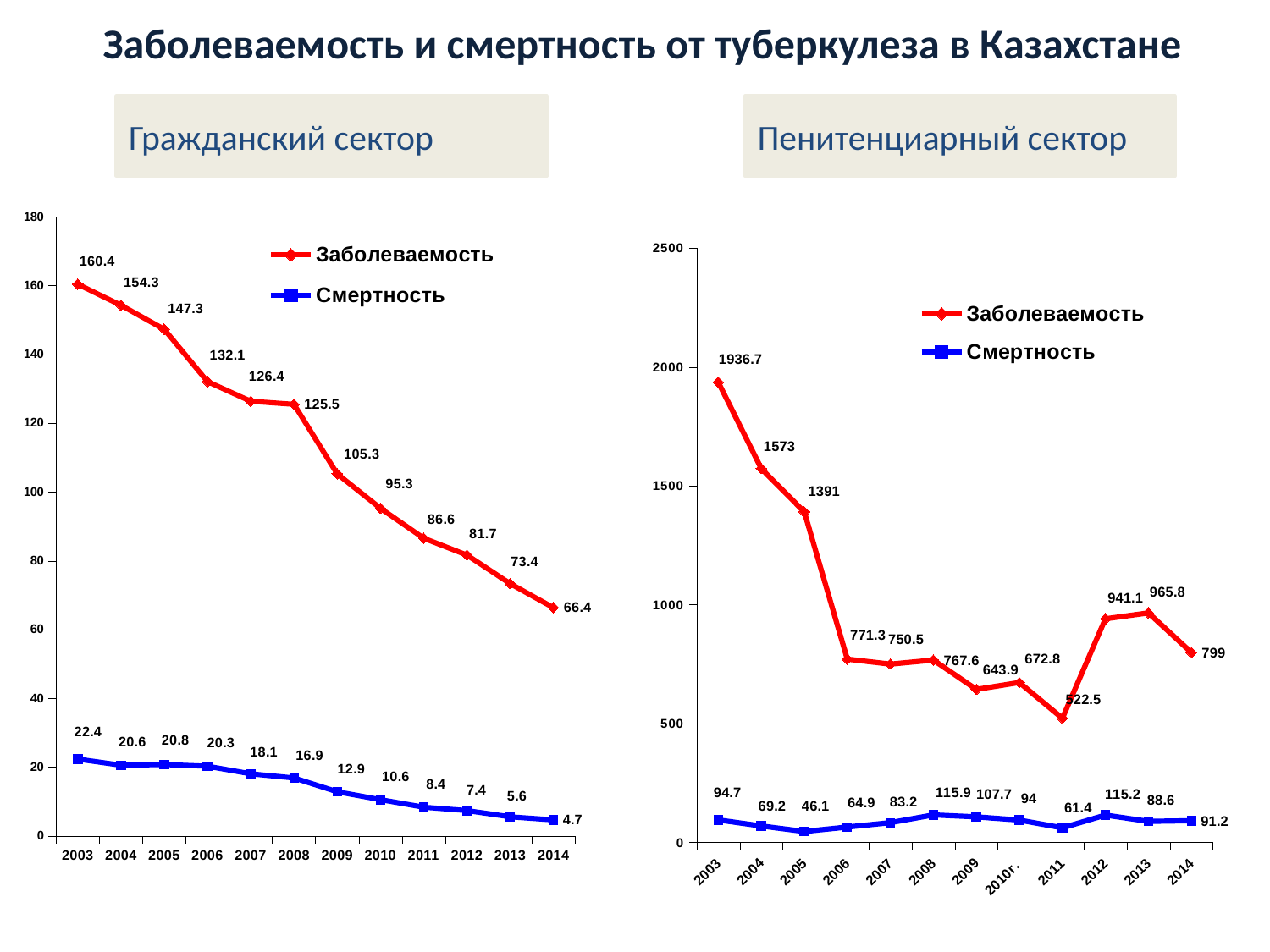
In the Пенитенциарный сектор chart, which is larger, the Заболеваемость value for 2012 or for 2013? 2013 In the Гражданский сектор chart, what is the Смертность value for 2014? 4.7 In the Пенитенциарный сектор chart, what is the Смертность value for 2008? 115.9 In the Пенитенциарный сектор chart, which year has the highest Заболеваемость value? 2003 In the Пенитенциарный сектор chart, what is the Заболеваемость value for 2011? 522.5 In the Гражданский сектор chart, what is the difference between the Заболеваемость values for 2003 and 2014? 94 In the Пенитенциарный сектор chart, which year has the lowest Смертность value? 2005 What kind of chart is the Гражданский сектор chart? line chart How many series does the legend of the Пенитенциарный сектор chart list? 2 How many years are shown on the x axis of the Гражданский сектор chart? 12 In the Гражданский сектор chart, what is the Заболеваемость value for 2003? 160.4 In the Гражданский сектор chart, does the Заболеваемость series rise or fall from 2003 to 2014? fall